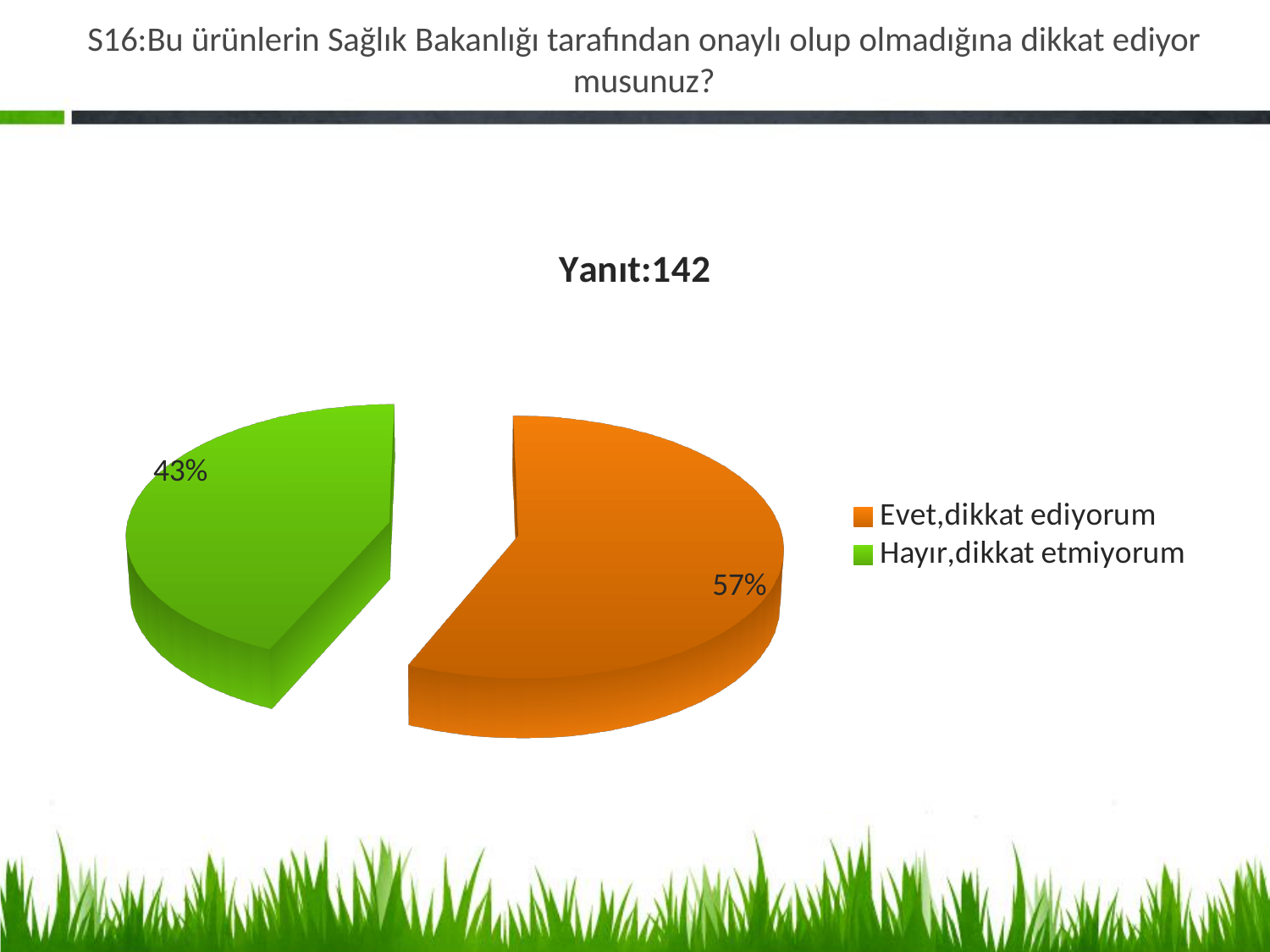
What kind of chart is shown on the slide? pie chart What is the difference in percentage points between the "Evet,dikkat ediyorum" and "Hayır,dikkat etmiyorum" slices? 14 Which slice of the pie is the largest? Evet,dikkat ediyorum How many entries does the legend list? 2 What is the chart's title? Yanıt:142 How many slices does the pie chart have? 2 What percentage of the pie is labelled "Evet,dikkat ediyorum"? 57% What colour is the "Hayır,dikkat etmiyorum" slice? green What percentage of the pie is labelled "Hayır,dikkat etmiyorum"? 43% What share of the pie does the "Evet,dikkat ediyorum" slice represent? 57% Which slice of the pie is the smallest? Hayır,dikkat etmiyorum Which is larger: the "Evet,dikkat ediyorum" slice or the "Hayır,dikkat etmiyorum" slice? Evet,dikkat ediyorum